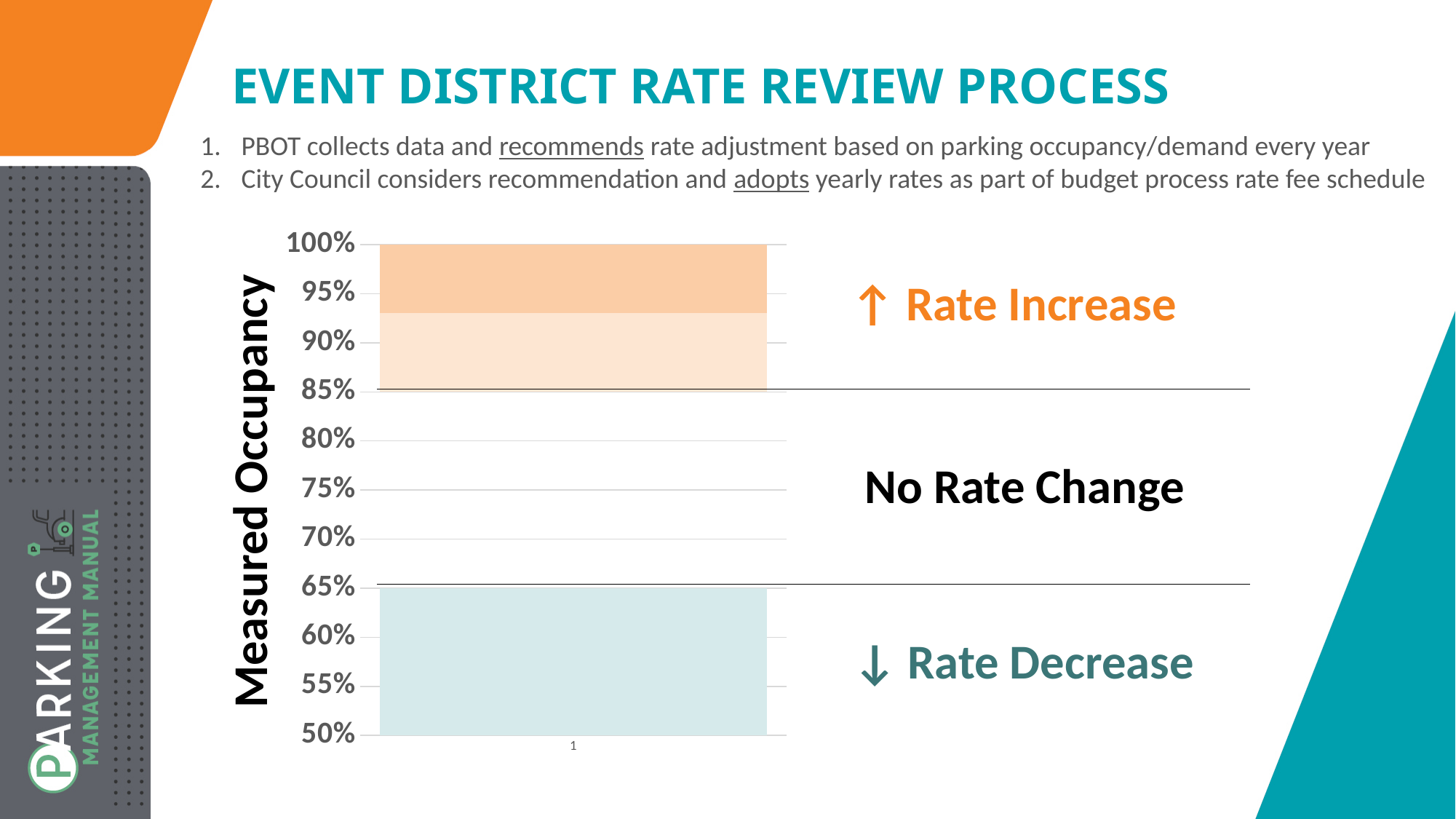
What is the title of the vertical axis of the chart? Measured Occupancy Which band covers a wider range of occupancy: 'No Rate Change' (65%–85%) or 'Rate Decrease' (50%–65%)? No Rate Change What kind of chart is shown on the slide? bar chart How many percentage points wide is the 'No Rate Change' band (from 65% to 85%)? 20 What colour is the 'Rate Increase' band at the top of the chart? orange What outcome is labelled for measured occupancy between 65% and 85%? No Rate Change What is the lowest value shown on the vertical axis of the chart? 50% What is the highest value shown on the vertical axis of the chart? 100% At what measured occupancy does the 'Rate Decrease' band end (its upper boundary)? 65% How many categories are plotted along the horizontal axis of the chart? 1 At what measured occupancy does the 'Rate Increase' band begin? 85% What is the interval between consecutive tick labels on the vertical axis? 5%